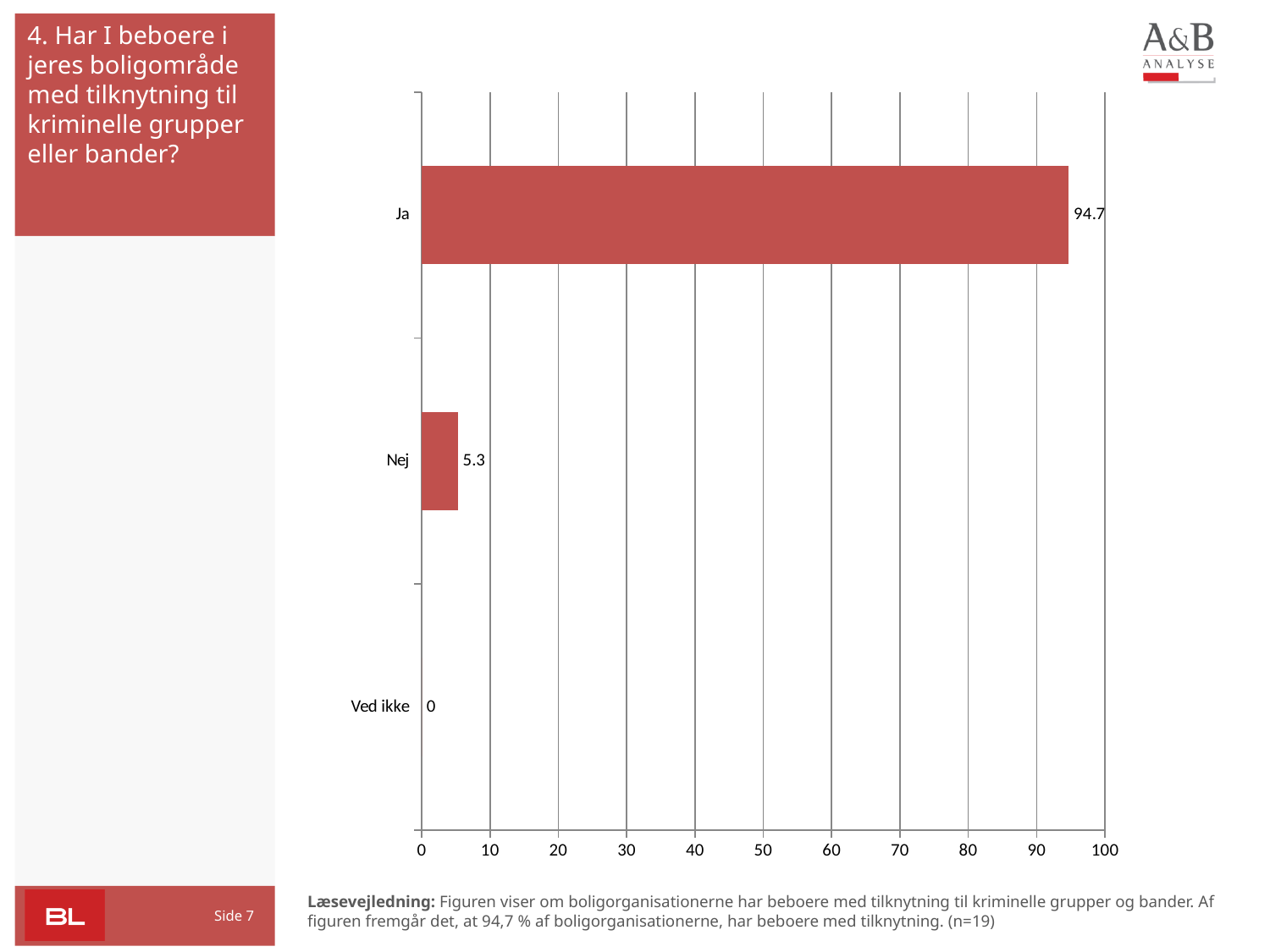
What is the value for Ja? 94.7 What kind of chart is shown on the slide? bar chart Which category has the lowest value? Ved ikke What is the highest value shown on the x axis? 100 Which category has the highest value? Ja Is the value for Ja greater or less than 90? greater Is the value for Nej greater or less than 10? less Which is larger, the value for Nej or the value for Ved ikke? Nej What is the difference between the values for Ja and Nej? 89.4 How many categories are shown in the chart? 3 What is the value for Nej? 5.3 What is the value for Ved ikke? 0